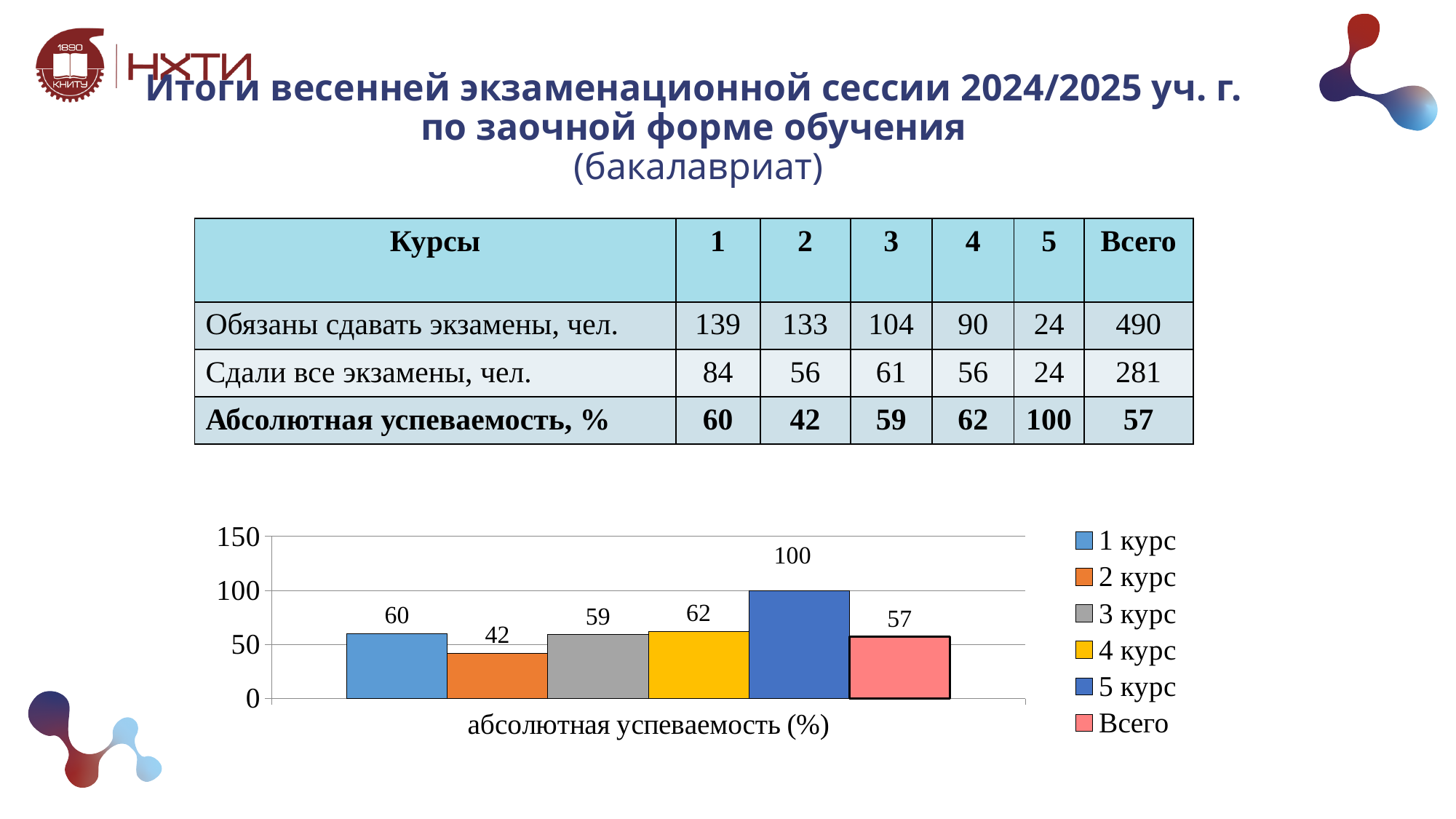
What is the label on the x axis of the chart? абсолютная успеваемость (%) Which series has the lowest value in the chart? 2 курс What is the value shown for 5 курс in the chart? 100 Is the value for 2 курс greater or less than 50? less What kind of chart is shown on the slide? bar chart Which series has the highest value in the chart? 5 курс How many series does the legend list? 6 Which is larger in the chart: the value for 4 курс or the value for 3 курс? 4 курс What colour is the bar for 4 курс? yellow What is the value shown for 1 курс in the chart? 60 What is the difference between the values for 5 курс and 2 курс? 58 What is the value shown for Всего in the chart? 57